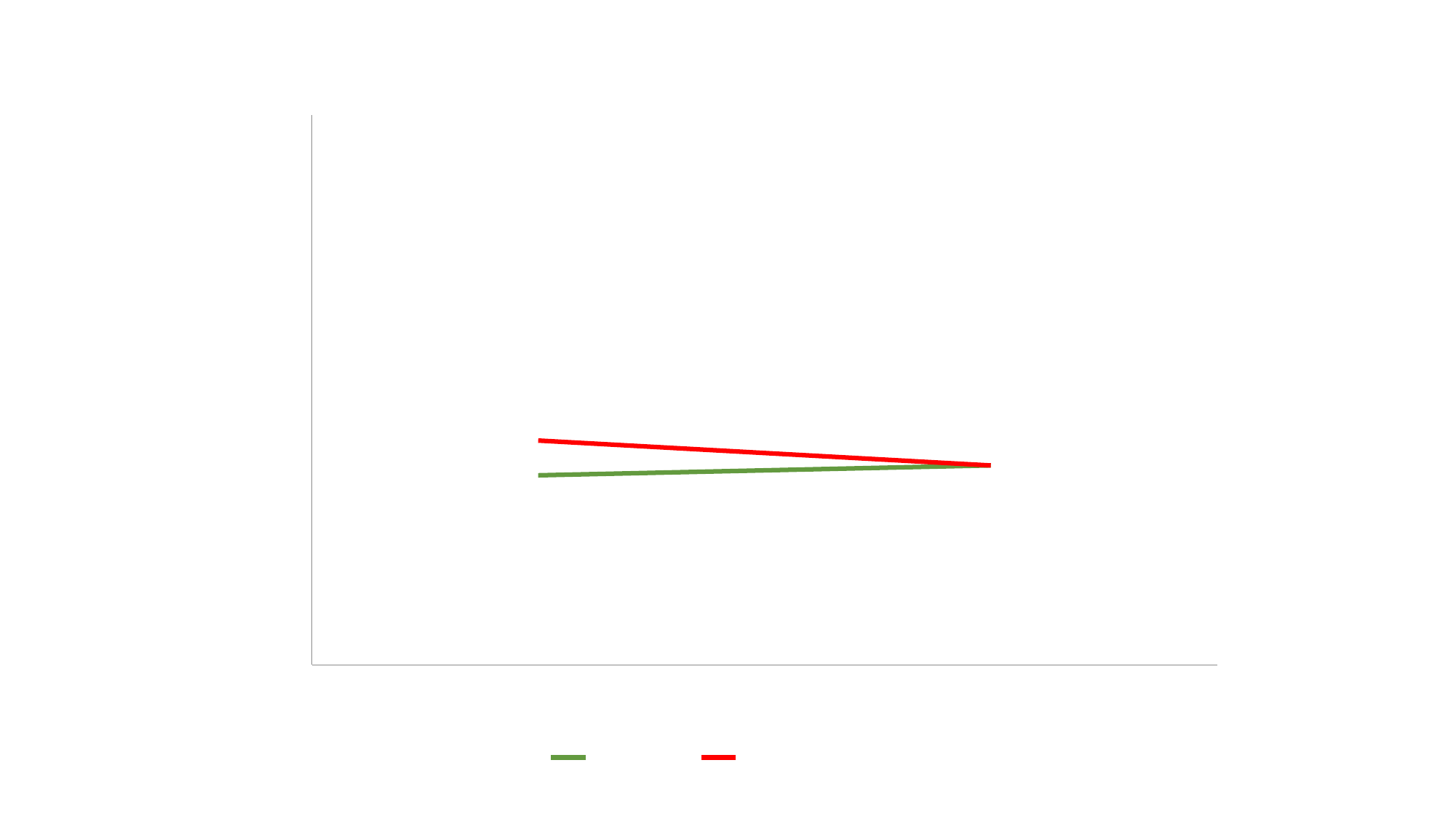
Where is the legend positioned relative to the plot area? below How many series does the legend list? 2 Does the green line rise or fall from left to right? rise What kind of chart is shown on the slide? line chart What colours are the two lines in the chart? green and red How many data points does each line have? 2 At the left end of the lines, which line is higher, the red or the green? red Does the red line rise or fall from left to right? fall